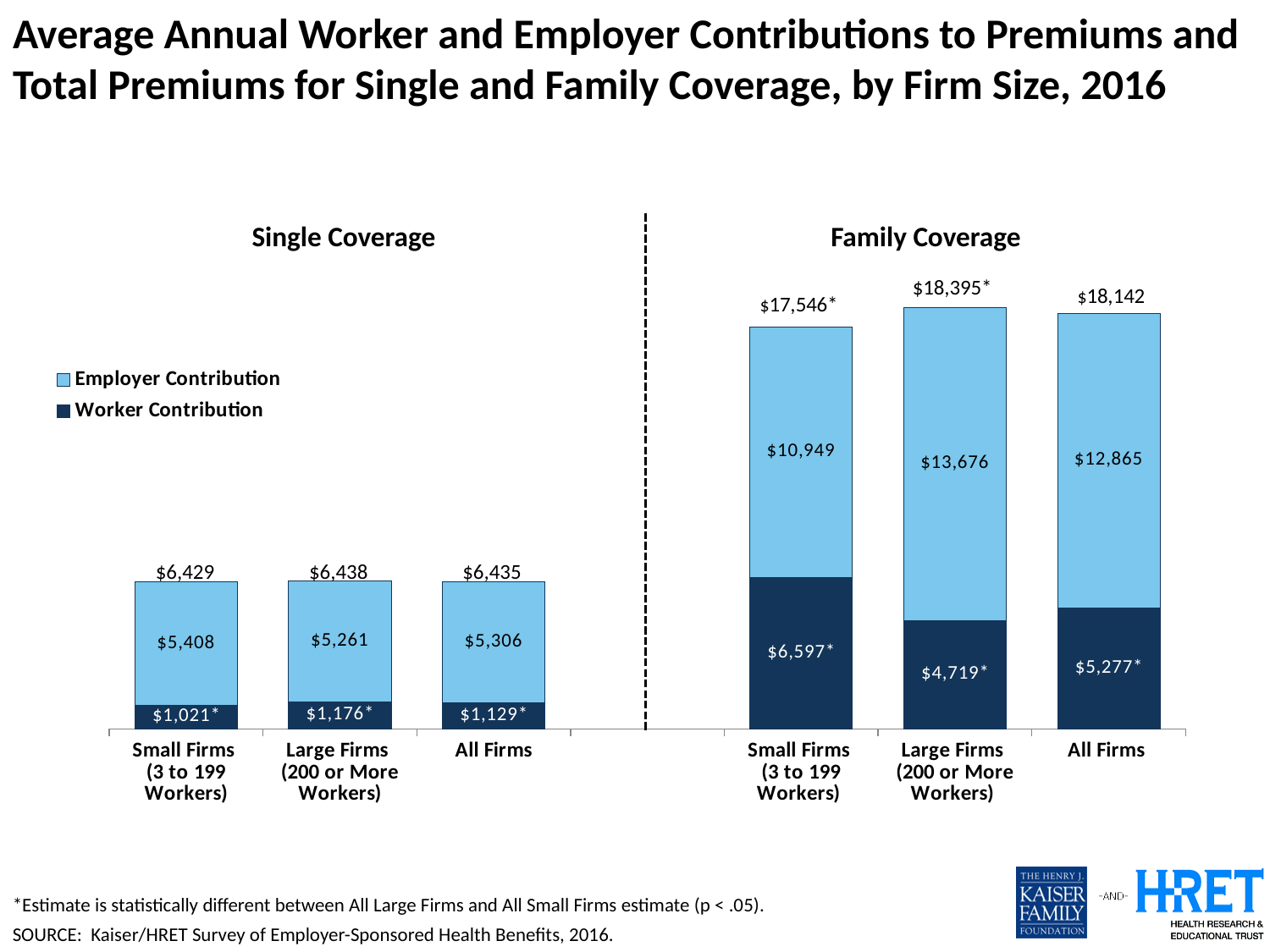
What is the Worker Contribution for Large Firms (200 or More Workers) under Family Coverage? $4,719 What is the total premium for Large Firms (200 or More Workers) under Single Coverage? $6,438 Which legend entry is shown in dark blue? Worker Contribution What is the Employer Contribution for Small Firms (3 to 199 Workers) under Single Coverage? $5,408 What type of chart is shown on the slide? Stacked bar chart How many series does the legend list? 2 Which firm size has the highest total premium under Family Coverage? Large Firms (200 or More Workers) What is the total premium for All Firms under Family Coverage? $18,142 Under Family Coverage, is the Worker Contribution larger for Small Firms or Large Firms? Small Firms How many firm-size categories are shown under Single Coverage? 3 What is the difference between the Employer Contribution for Large Firms and Small Firms under Family Coverage? $2,727 Which firm size has the lowest Worker Contribution under Single Coverage? Small Firms (3 to 199 Workers)